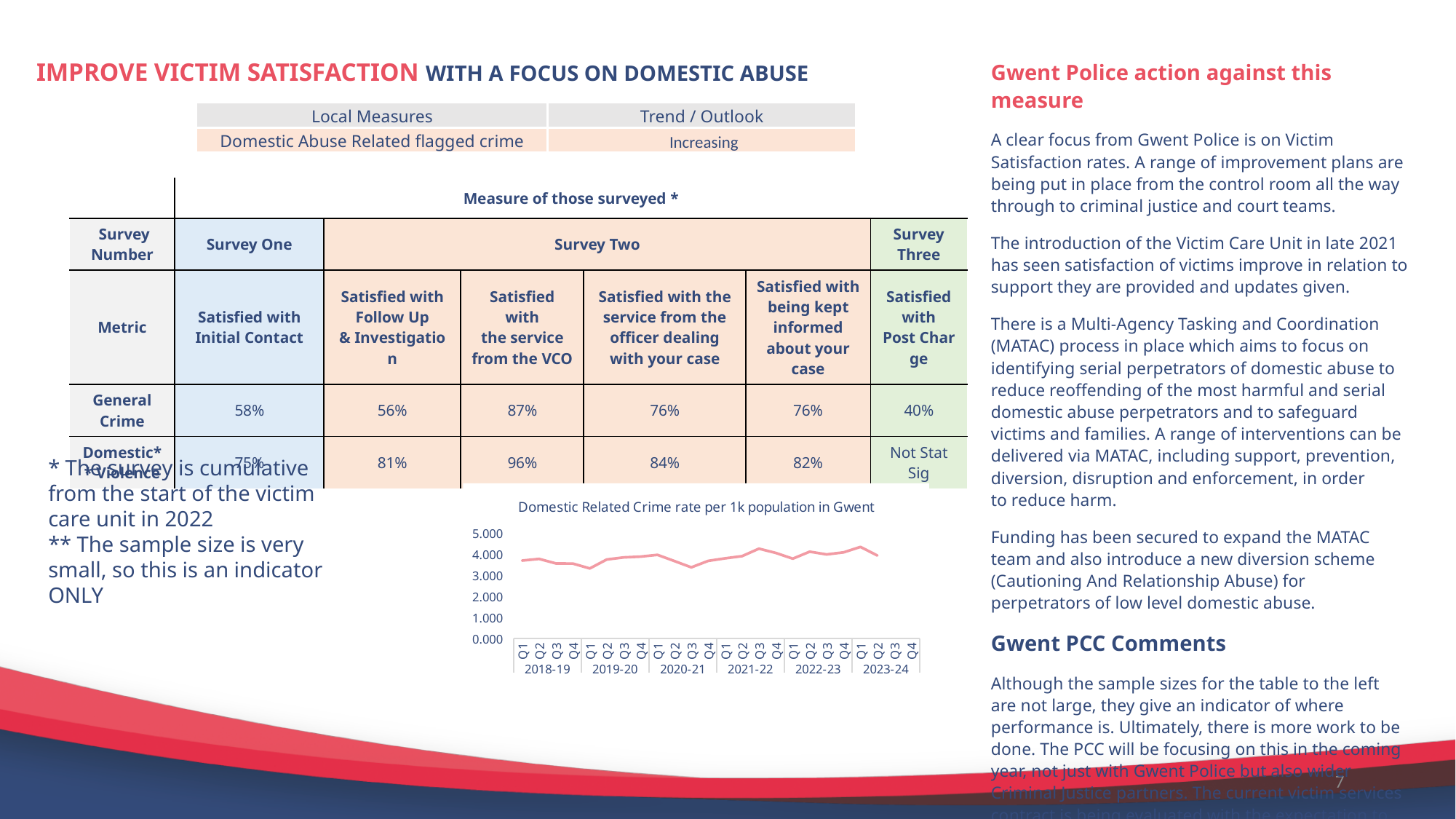
How many financial years are labelled on the x axis of the Domestic Related Crime rate chart? 6 In the Domestic Related Crime rate chart, does the line ever fall below 2.000? No In the Domestic Related Crime rate chart, is the value for Q1 2018-19 greater or less than 3.000? greater In the Domestic Related Crime rate chart, which is the last financial year shown on the x axis? 2023-24 What is the title of the chart on the slide? Domestic Related Crime rate per 1k population in Gwent What is the highest value shown on the y axis of the Domestic Related Crime rate chart? 5.000 In the Domestic Related Crime rate chart, is the value for Q2 2023-24 greater or less than 5.000? less In the Domestic Related Crime rate chart, which is the first financial year shown on the x axis? 2018-19 How many data series are plotted in the Domestic Related Crime rate chart? 1 What kind of chart is shown at the bottom of the slide? Line chart